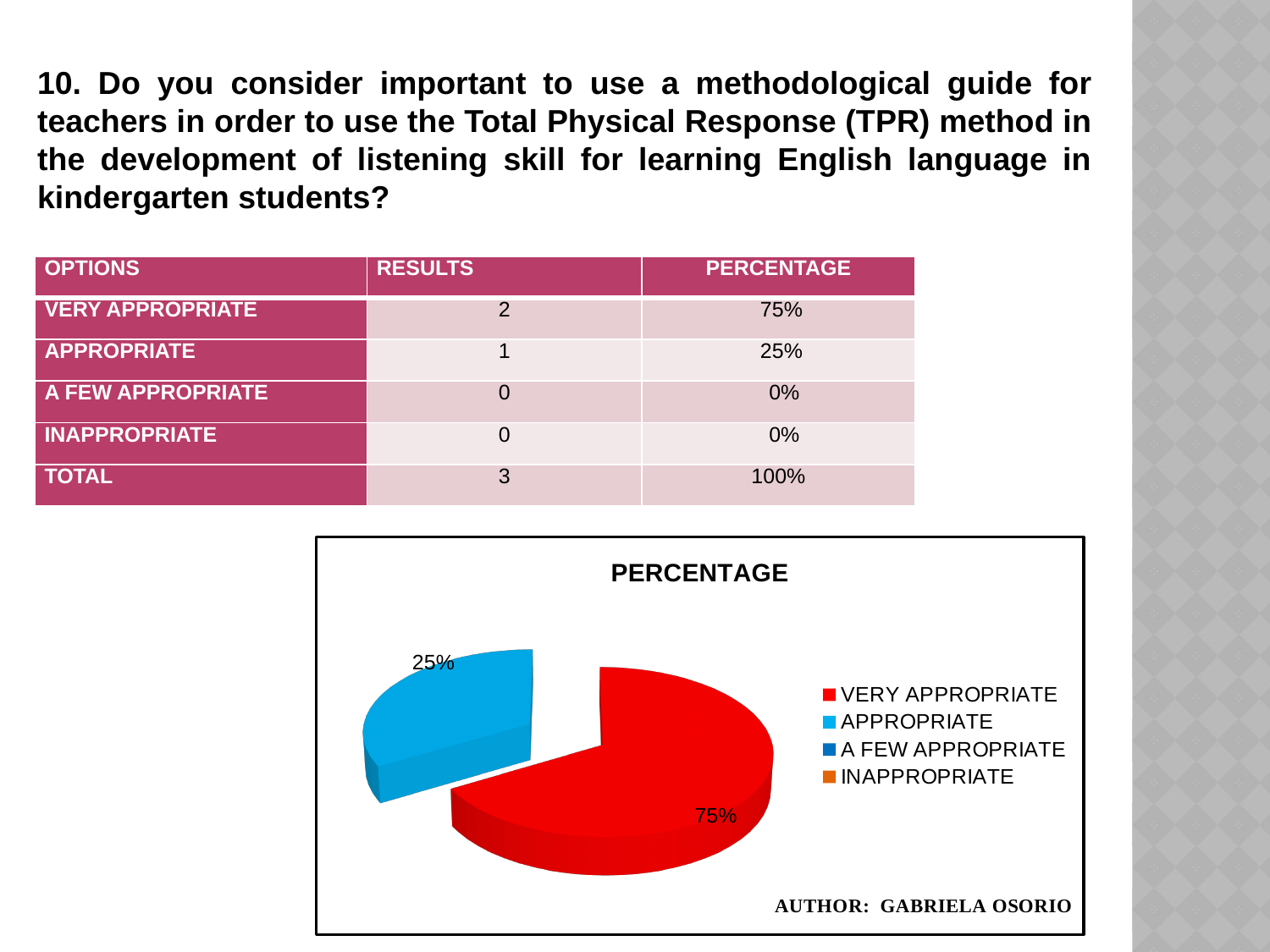
Which category has the largest slice of the pie? VERY APPROPRIATE What percentage does the VERY APPROPRIATE slice show? 75% What percentage does the APPROPRIATE slice show? 25% What is the difference in percentage points between the VERY APPROPRIATE and APPROPRIATE slices? 50 How many entries does the legend list? 4 What kind of chart is shown on the slide? Pie chart What colour is the VERY APPROPRIATE slice? Red How many slices with a visible data label are shown in the pie? 2 What is the title of the chart? PERCENTAGE Which is larger, the VERY APPROPRIATE slice or the APPROPRIATE slice? VERY APPROPRIATE